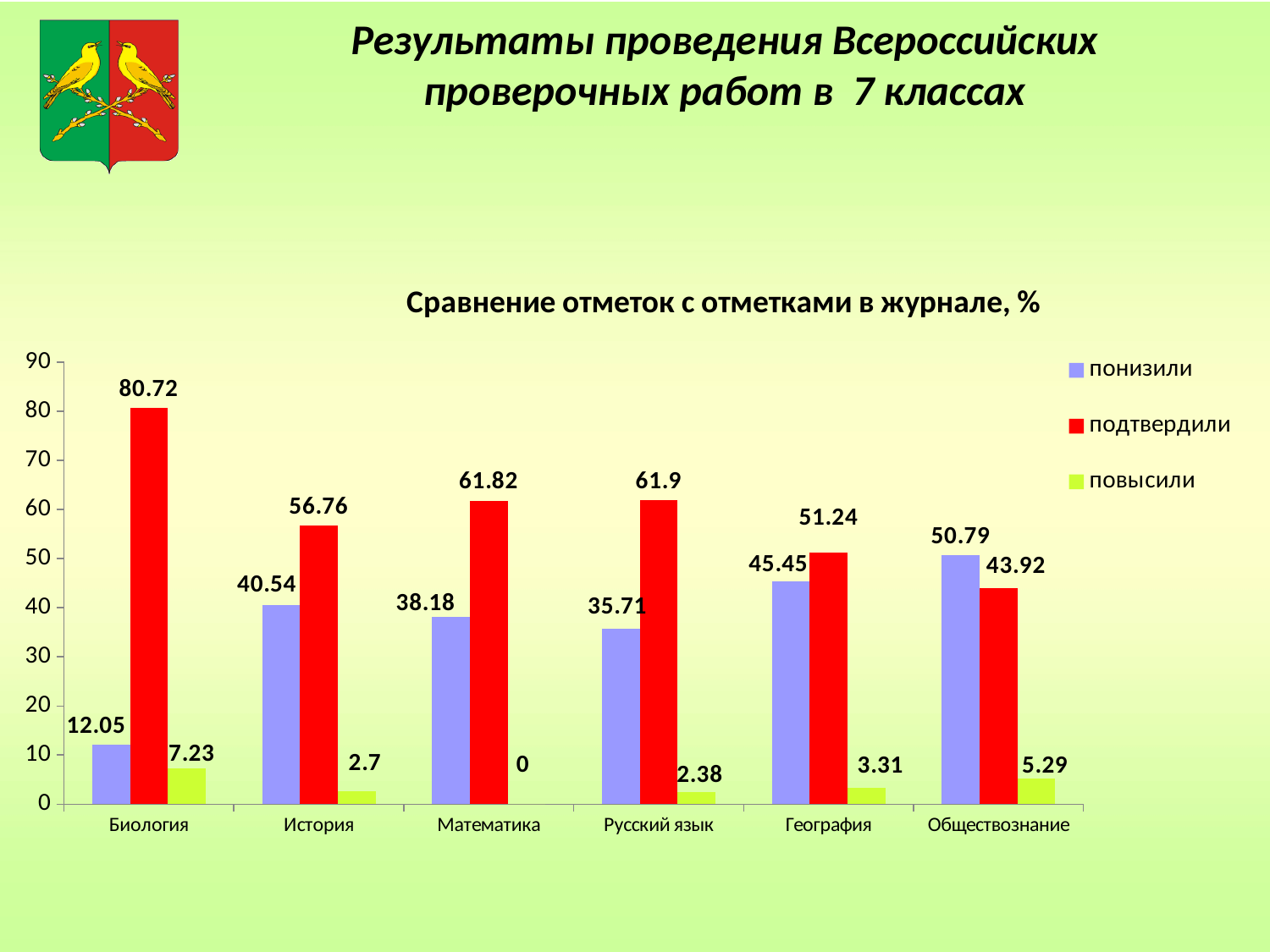
Which subject has the highest value in the подтвердили series? Биология What is the title of the chart? Сравнение отметок с отметками в журнале, % What kind of chart is shown on the slide? bar chart What is the value of the понизили series for История? 40.54 How many subjects are shown on the x axis? 6 Which subject has the highest value in the понизили series? Обществознание What is the difference between the подтвердили and понизили values for Биология? 68.67 What is the value of the подтвердили series for Биология? 80.72 What is the value of the повысили series for Обществознание? 5.29 For География, which is larger: the понизили value or the подтвердили value? подтвердили How many series does the legend list? 3 Which subject has the lowest value in the повысили series? Математика